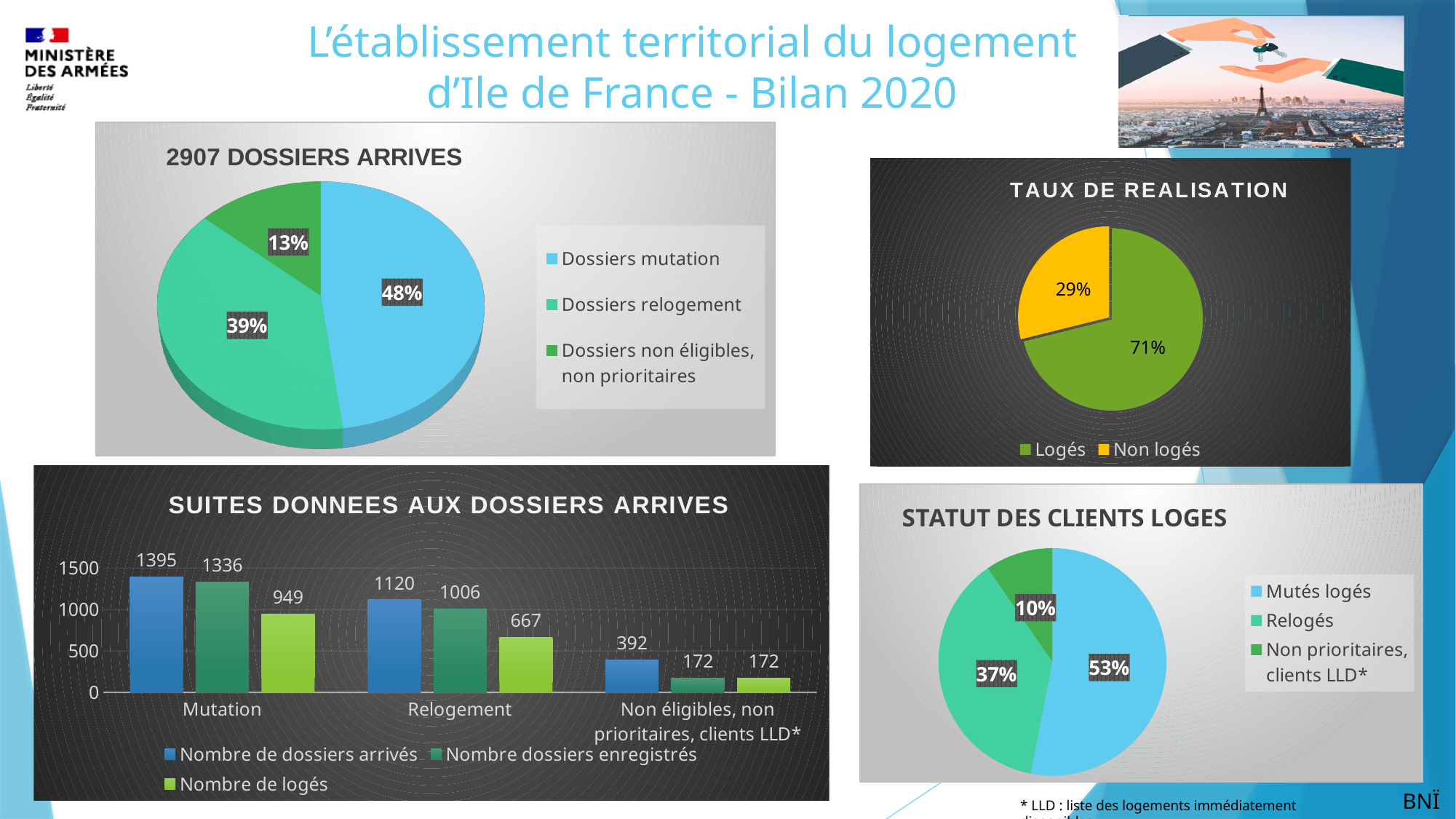
In the 'SUITES DONNEES AUX DOSSIERS ARRIVES' chart, what is the difference between Nombre de dossiers arrivés and Nombre dossiers enregistrés for Relogement? 114 In the 'SUITES DONNEES AUX DOSSIERS ARRIVES' chart, what is the value of Nombre de dossiers arrivés for Mutation? 1395 In the 'SUITES DONNEES AUX DOSSIERS ARRIVES' chart, what is the value of Nombre de logés for Relogement? 667 In the '2907 DOSSIERS ARRIVES' pie chart, which category has the smallest slice? Dossiers non éligibles, non prioritaires In the 'STATUT DES CLIENTS LOGES' pie chart, what share is shown for Relogés? 37% In the 'SUITES DONNEES AUX DOSSIERS ARRIVES' chart, how many categories are shown on the x axis? 3 In the 'TAUX DE REALISATION' pie chart, what percentage is shown for Non logés? 29% In the 'SUITES DONNEES AUX DOSSIERS ARRIVES' chart, what kind of chart is it? Bar chart In the 'STATUT DES CLIENTS LOGES' pie chart, which category has the largest slice? Mutés logés In the 'SUITES DONNEES AUX DOSSIERS ARRIVES' chart, which category has the lowest value for Nombre de dossiers arrivés? Non éligibles, non prioritaires, clients LLD* In the '2907 DOSSIERS ARRIVES' pie chart, what share is shown for Dossiers mutation? 48% In the 'TAUX DE REALISATION' pie chart, how many series does the legend list? 2